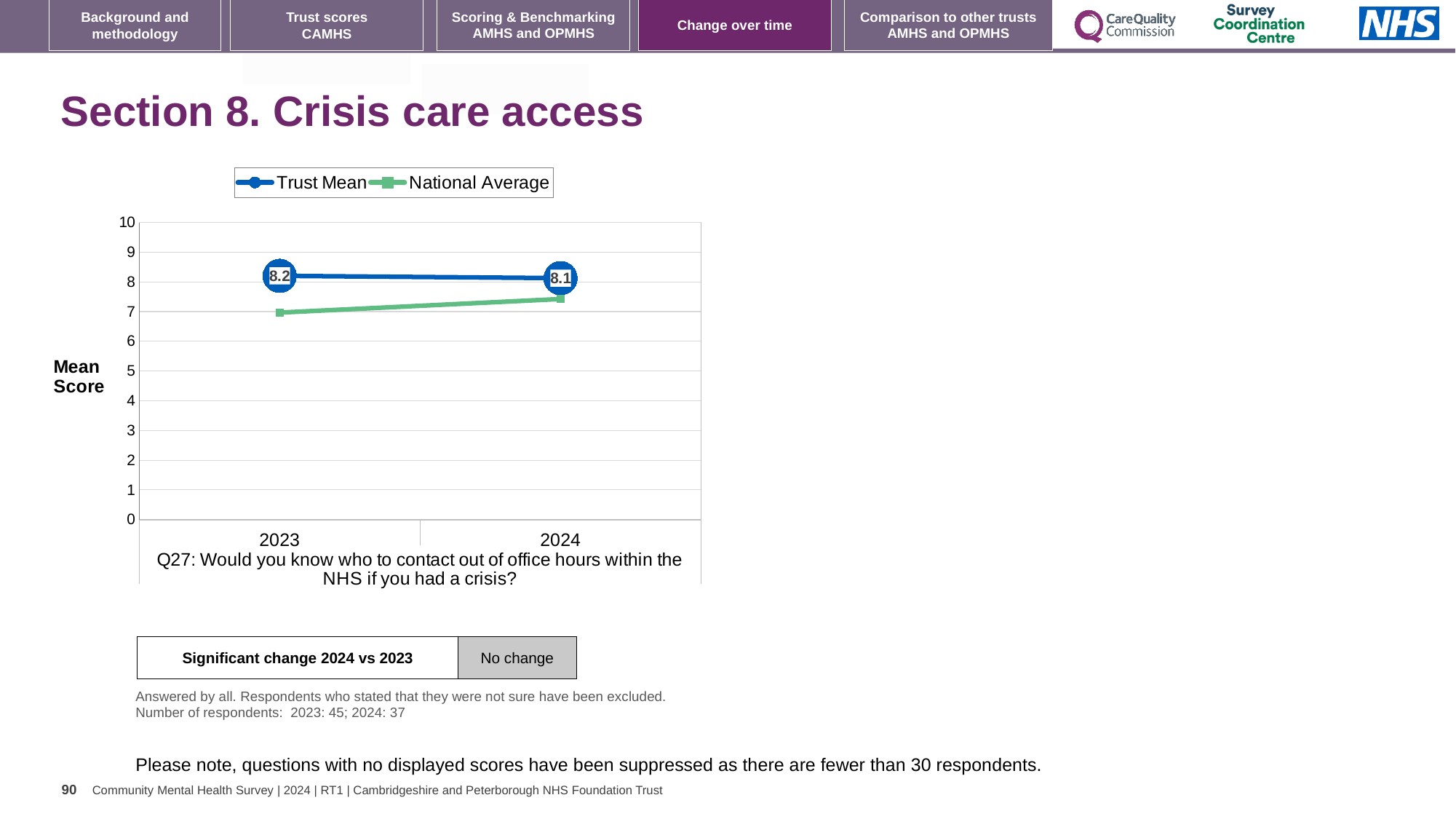
How many series does the legend list? 2 What is the label on the y axis of the chart? Mean Score How many years are plotted on the x axis? 2 Does the Trust Mean rise or fall from 2023 to 2024? fall What is the difference between the Trust Mean in 2023 and in 2024? 0.1 What is the Trust Mean value for 2024? 8.1 Does the National Average rise or fall from 2023 to 2024? rise What is the Trust Mean value for 2023? 8.2 What type of chart is shown on the slide? line chart Is the National Average value for 2023 greater or less than 8? less Is the National Average value for 2024 greater or less than 7? greater In 2023, which is larger: the Trust Mean or the National Average? Trust Mean